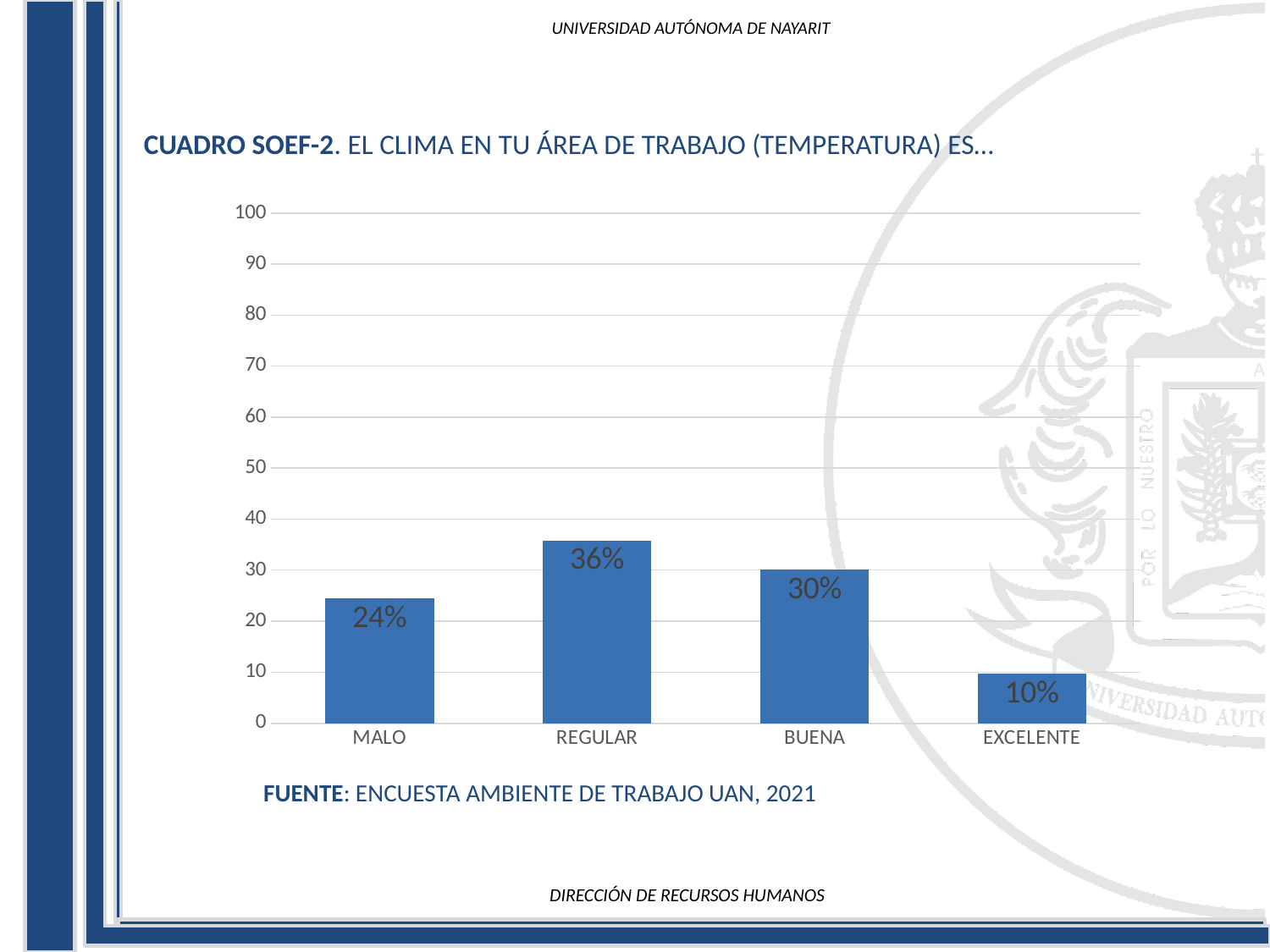
What is the value for REGULAR? 36% How many categories are shown on the x axis? 4 Which category has the highest value? REGULAR What is the value for EXCELENTE? 10% What kind of chart is shown on the slide? bar chart What is the difference between the values for MALO and EXCELENTE? 14% What is the difference between the values for REGULAR and BUENA? 6% What is the value for MALO? 24% What source is cited below the chart? ENCUESTA AMBIENTE DE TRABAJO UAN, 2021 Which category has the lowest value? EXCELENTE Is the value for BUENA greater or less than 40? less Which is larger, the value for MALO or the value for BUENA? BUENA